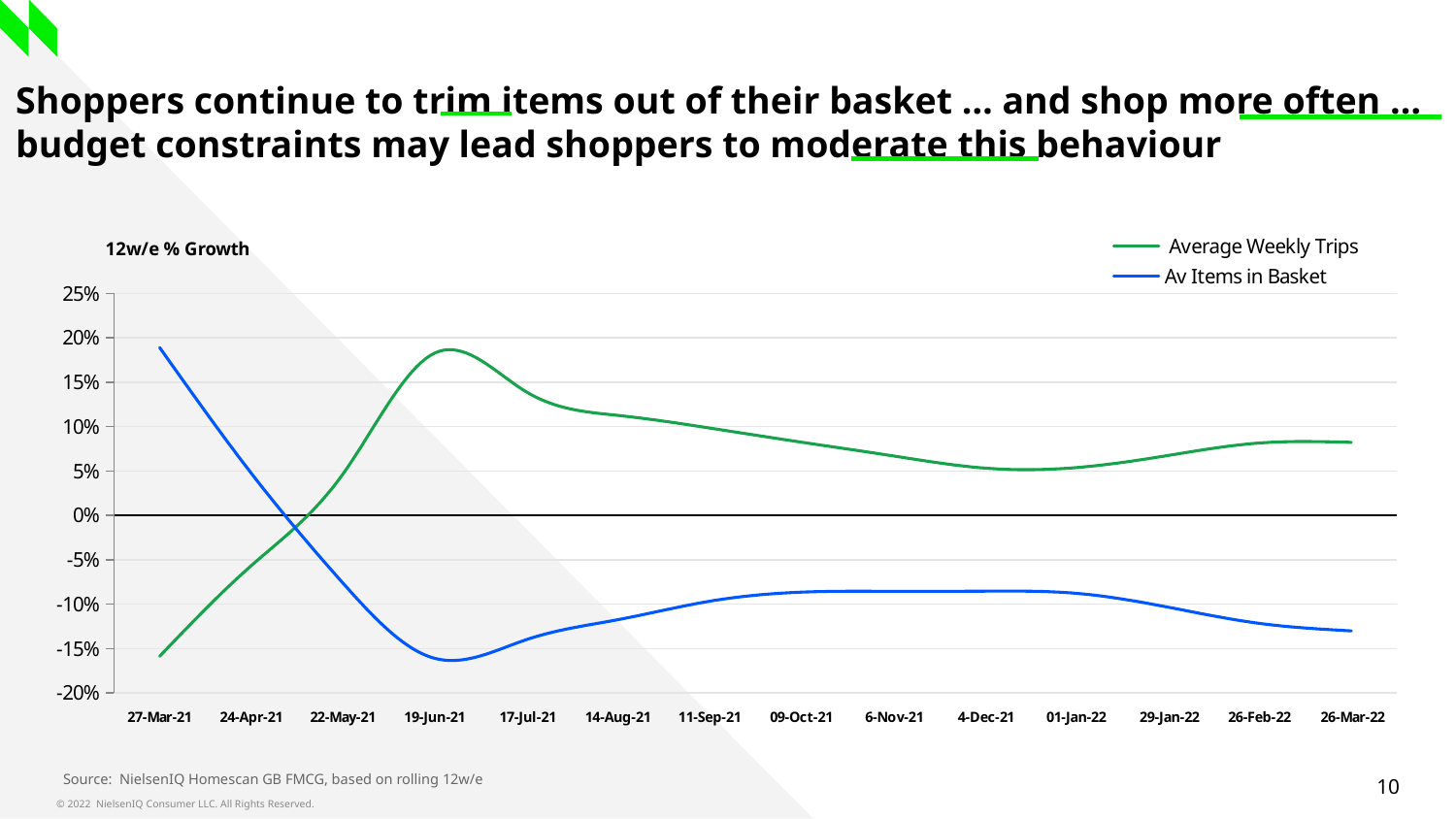
Is the value for Av Items in Basket at 27-Mar-21 greater or less than 15%? greater What is the label shown above the y axis of the chart? 12w/e % Growth Is the value for Av Items in Basket at 26-Mar-22 greater or less than -10%? less Does the Av Items in Basket line rise or fall between 27-Mar-21 and 19-Jun-21? fall Does the Average Weekly Trips line rise or fall between 27-Mar-21 and 19-Jun-21? rise How many dates are shown along the x axis? 14 How many series does the legend list? 2 At 26-Mar-22, which series has the higher value, Average Weekly Trips or Av Items in Basket? Average Weekly Trips Is the value for Average Weekly Trips at 27-Mar-21 greater or less than -10%? less At 27-Mar-21, which series has the higher value, Average Weekly Trips or Av Items in Basket? Av Items in Basket What kind of chart is shown on the slide? line chart